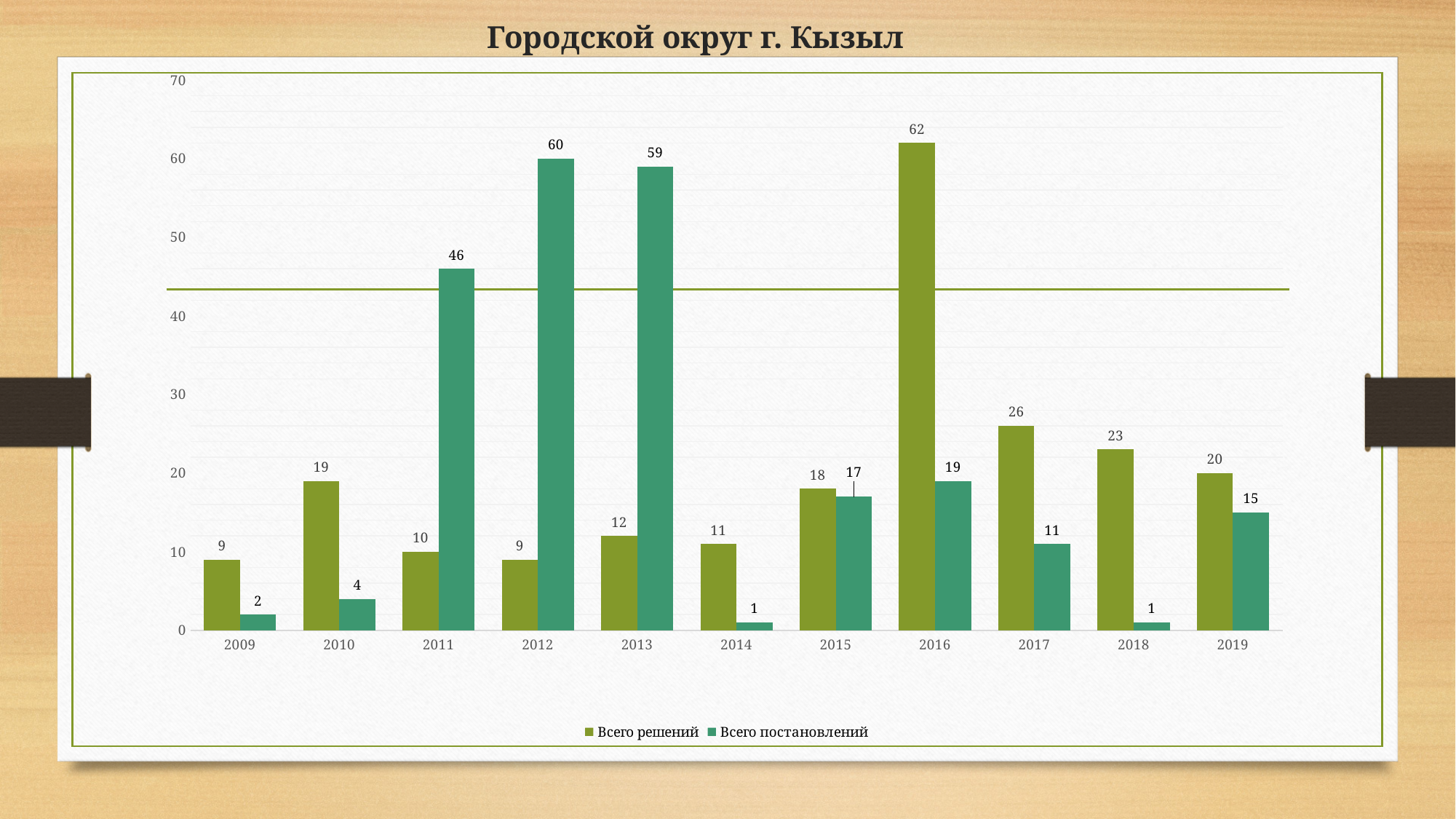
In 2013, which is larger: Всего решений or Всего постановлений? Всего постановлений What is the value of Всего решений for 2016? 62 What is the difference between Всего решений and Всего постановлений in 2016? 43 What is the title of the slide? Городской округ г. Кызыл How many years are shown on the x axis? 11 What is the value of Всего постановлений for 2012? 60 Which year has the highest value for Всего решений? 2016 Which year has the highest value for Всего постановлений? 2012 What kind of chart is shown on the slide? Bar chart What is the value of Всего постановлений for 2011? 46 Which year has the lowest value for Всего решений? 2009 and 2012 How many series does the legend list? 2